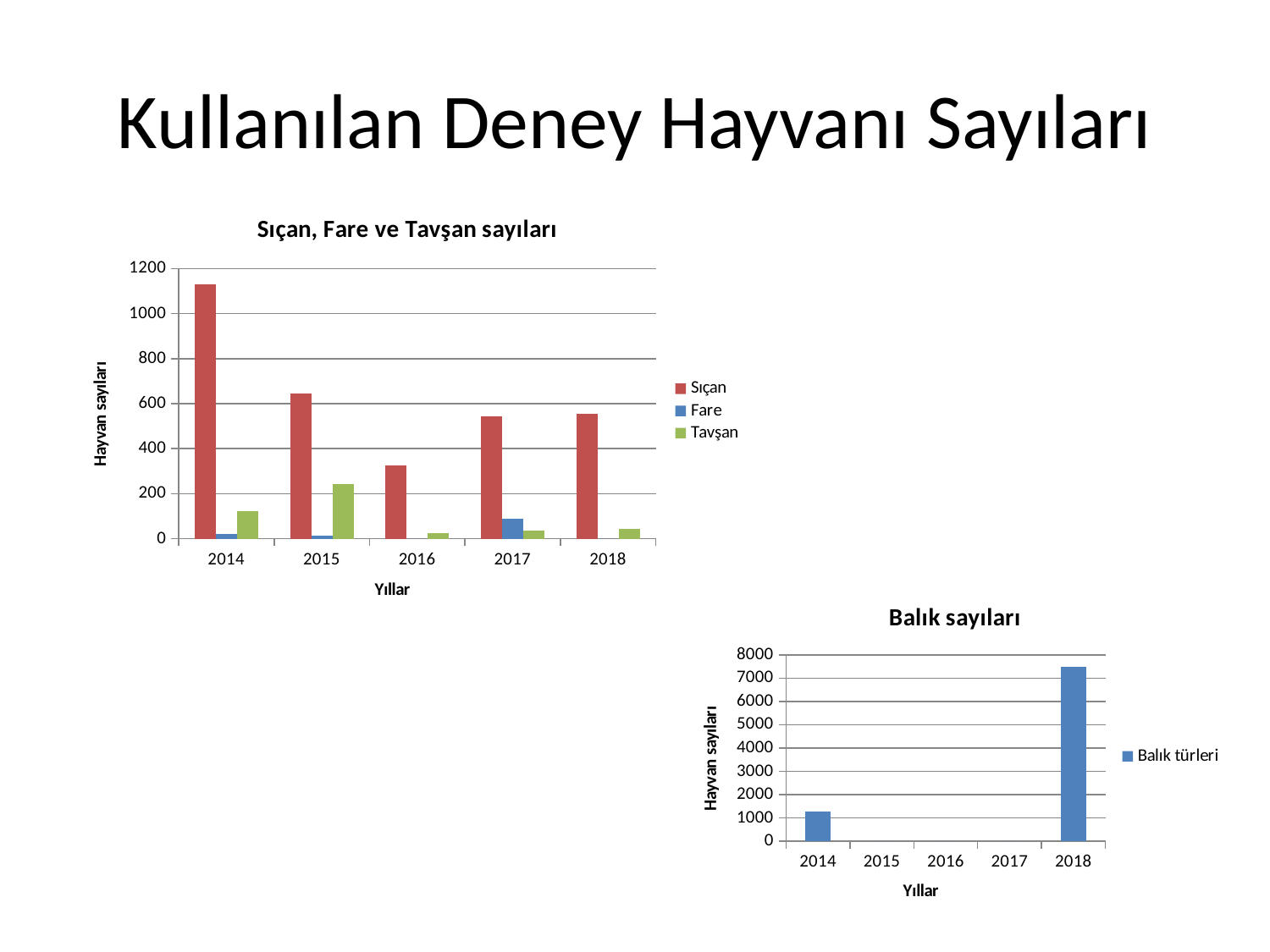
In the chart titled 'Sıçan, Fare ve Tavşan sayıları', which year has the lowest Sıçan value? 2016 In the chart titled 'Sıçan, Fare ve Tavşan sayıları', what kind of chart is shown? bar chart In the chart titled 'Sıçan, Fare ve Tavşan sayıları', is the Tavşan value for 2015 greater or less than 200? greater In the chart titled 'Sıçan, Fare ve Tavşan sayıları', which year has the highest Sıçan value? 2014 In the chart titled 'Balık sayıları', which year has the highest value? 2018 In the chart titled 'Sıçan, Fare ve Tavşan sayıları', which year has the highest Tavşan value? 2015 In the chart titled 'Balık sayıları', is the value for 2018 greater or less than 7000? greater In the chart titled 'Sıçan, Fare ve Tavşan sayıları', how many series does the legend list? 3 In the chart titled 'Sıçan, Fare ve Tavşan sayıları', is the Sıçan value for 2014 greater or less than 1000? greater In the chart titled 'Balık sayıları', what is the legend entry? Balık türleri In the chart titled 'Sıçan, Fare ve Tavşan sayıları', which year has the larger Sıçan value, 2015 or 2017? 2015 In the chart titled 'Balık sayıları', how many years are shown on the x axis? 5